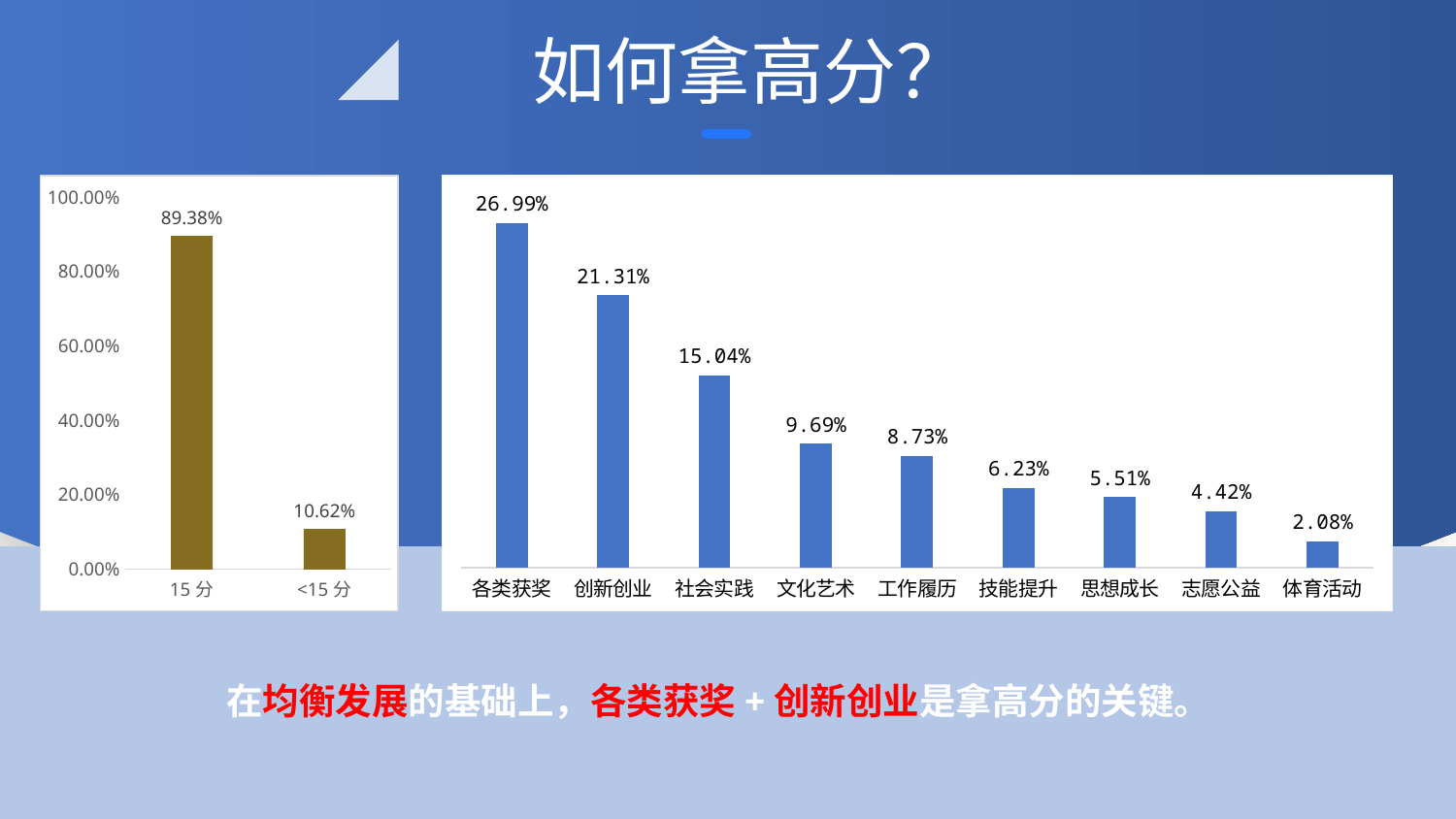
In the right chart, what is the value for 工作履历? 8.73% In the left chart, what is the value for <15 分? 10.62% In the right chart, which category has the lowest value? 体育活动 In the right chart, do the values rise or fall from left to right along the x axis? fall In the right chart, which is larger, the value for 文化艺术 or the value for 技能提升? 文化艺术 In the right chart, how many categories are shown on the x axis? 9 In the left chart, what is the difference between the values for 15 分 and <15 分? 78.76% In the right chart, what is the difference between the values for 各类获奖 and 社会实践? 11.95% In the left chart, how many categories are shown on the x axis? 2 In the right chart, what is the value for 创新创业? 21.31% In the left chart, what is the value for 15 分? 89.38% In the right chart, which category has the highest value? 各类获奖